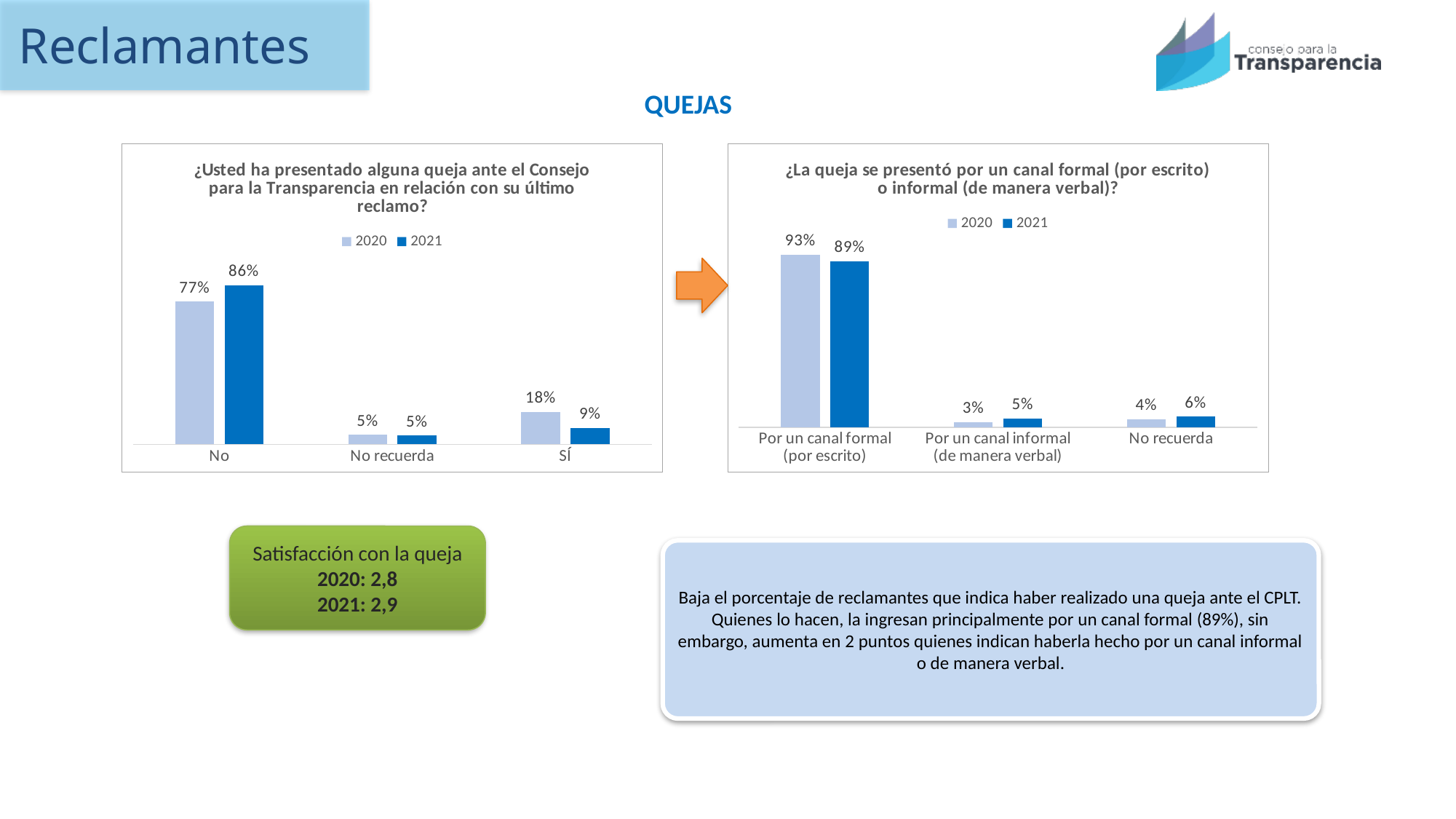
In the left chart (¿Usted ha presentado alguna queja...?), how many categories are shown on the x axis? 3 In the left chart (¿Usted ha presentado alguna queja...?), how many series does the legend list? 2 In the right chart (¿La queja se presentó por un canal formal...?), what is the difference between the 2020 and 2021 values for 'Por un canal formal (por escrito)'? 4% In the right chart (¿La queja se presentó por un canal formal...?), which category has the lowest value in 2020? Por un canal informal (de manera verbal) In the left chart (¿Usted ha presentado alguna queja...?), what is the difference between the 2020 and 2021 values for 'SÍ'? 9% In the right chart (¿La queja se presentó por un canal formal...?), what is the value for 'No recuerda' in 2021? 6% In the left chart (¿Usted ha presentado alguna queja...?), what is the value for 'SÍ' in 2020? 18% What kind of chart is the right chart (¿La queja se presentó por un canal formal...?)? bar chart In the right chart (¿La queja se presentó por un canal formal...?), is the 2021 value for 'Por un canal informal (de manera verbal)' larger or smaller than the 2020 value? larger In the left chart (¿Usted ha presentado alguna queja...?), which category has the highest value in 2020? No In the left chart (¿Usted ha presentado alguna queja...?), what is the value for 'No' in 2021? 86% In the right chart (¿La queja se presentó por un canal formal...?), what is the value for 'Por un canal formal (por escrito)' in 2020? 93%